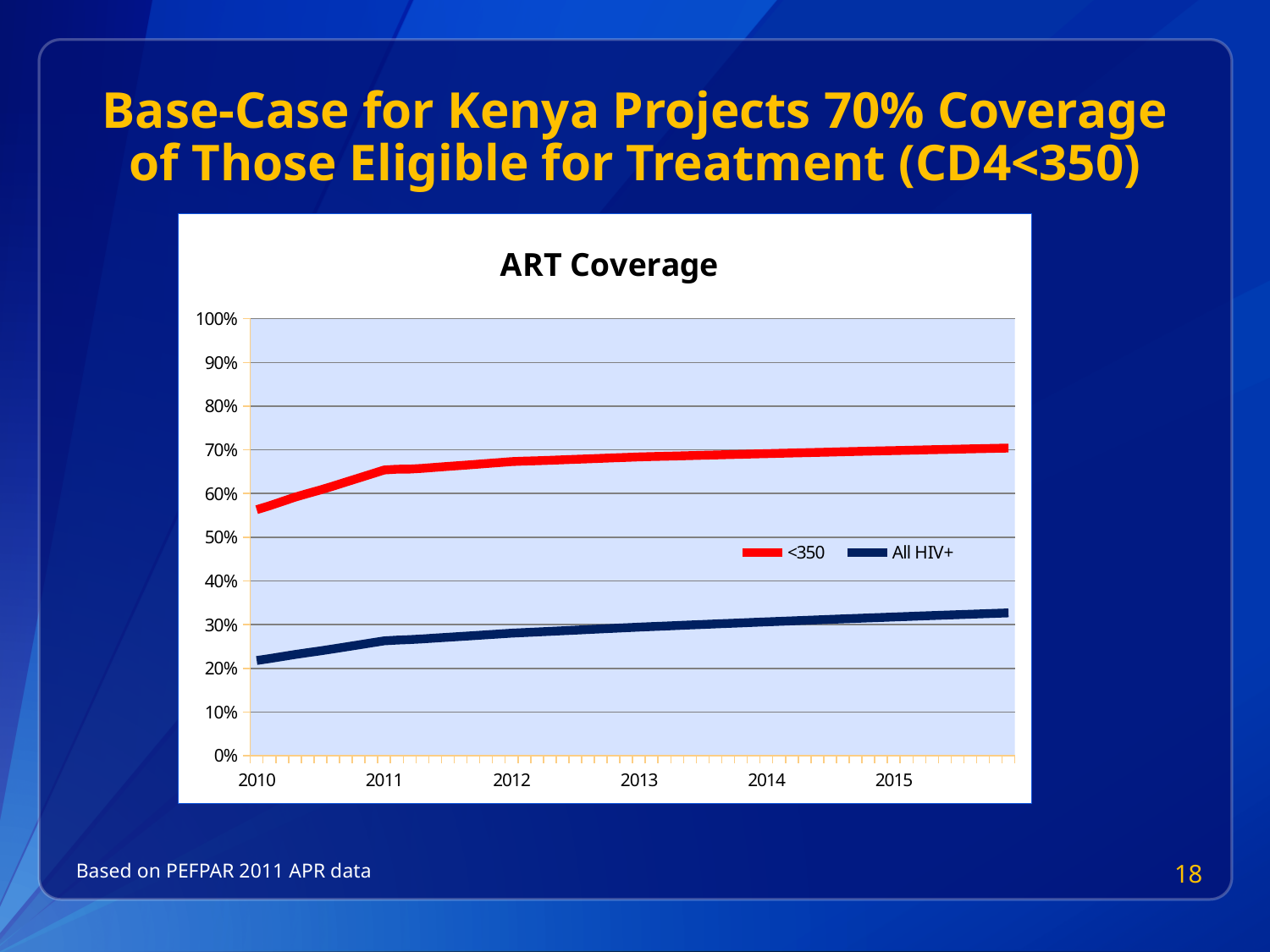
Is the value for All HIV+ in 2010 greater or less than 20%? greater What kind of chart is shown on the slide? line chart How many series does the legend list? 2 Does the <350 series rise or fall from 2010 to 2015? rise What is the title of the chart? ART Coverage Which series is drawn in red? <350 Is the value for <350 in 2010 greater or less than 60%? less Is the value for All HIV+ in 2011 greater or less than 30%? less Does the All HIV+ series rise or fall from 2010 to 2015? rise In 2013, which series has the higher value, <350 or All HIV+? <350 How many years are labeled on the x axis? 6